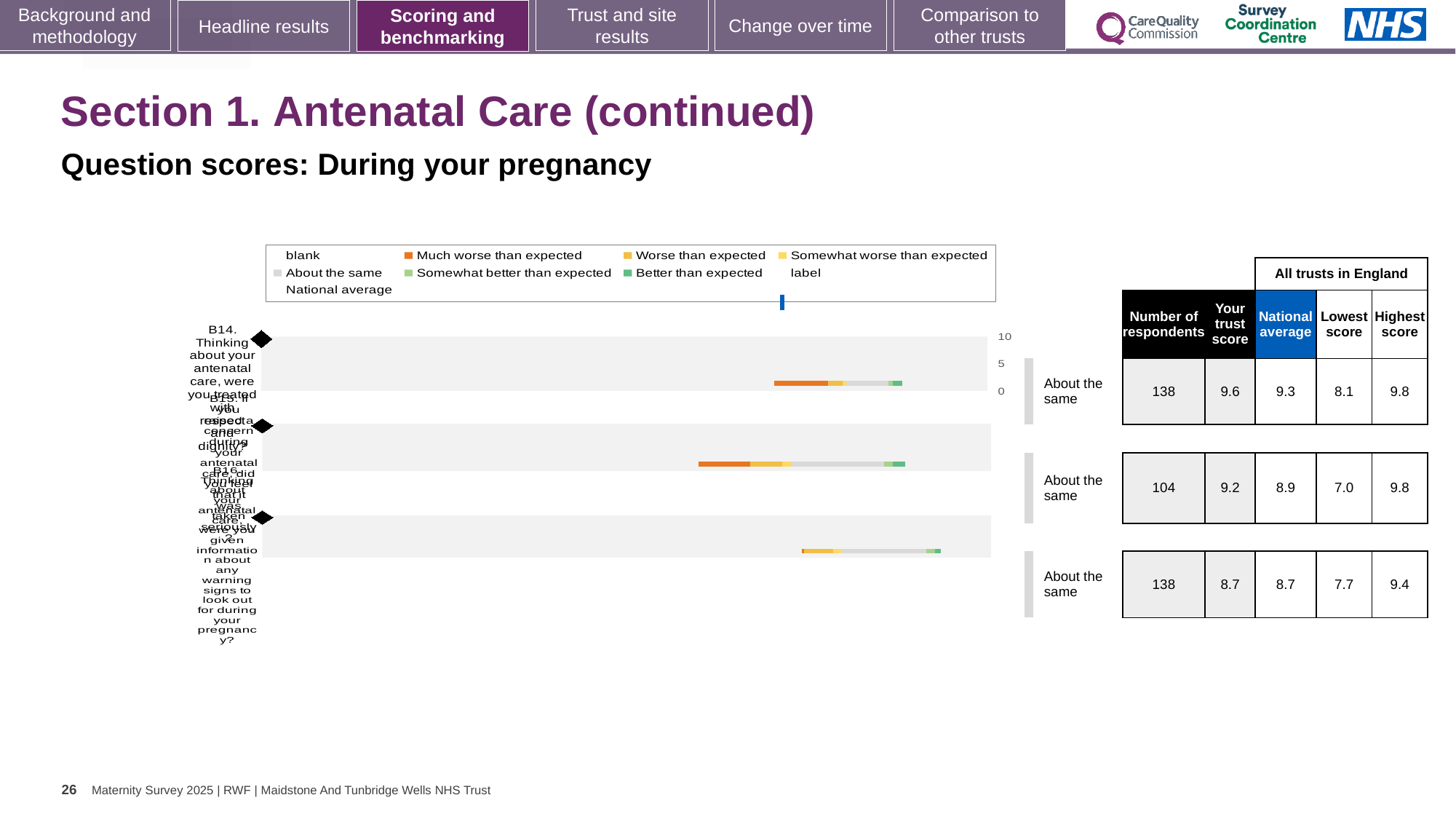
What kind of chart is shown on the slide? bar chart What is the difference between the trust score and the national average for the top row, question B14? 0.3 Which question row has the highest trust score? B14 (top row) What is the national average for the bottom row, question B16 (warning signs to look out for)? 8.7 What is the lowest score across all trusts in England for the middle row, question B15? 7.0 How many question rows (bars) are plotted in the chart? 3 What colour does the legend use for 'Much worse than expected'? orange What is the trust score for the top row, question B14 (treated with respect and dignity)? 9.6 What benchmark category is shown for all three question rows? About the same How many respondents are listed for the middle row, question B15 (concern taken seriously)? 104 For the middle row, question B15, which is larger: the trust score or the national average? the trust score Which question row has the lowest trust score? B16 (bottom row)